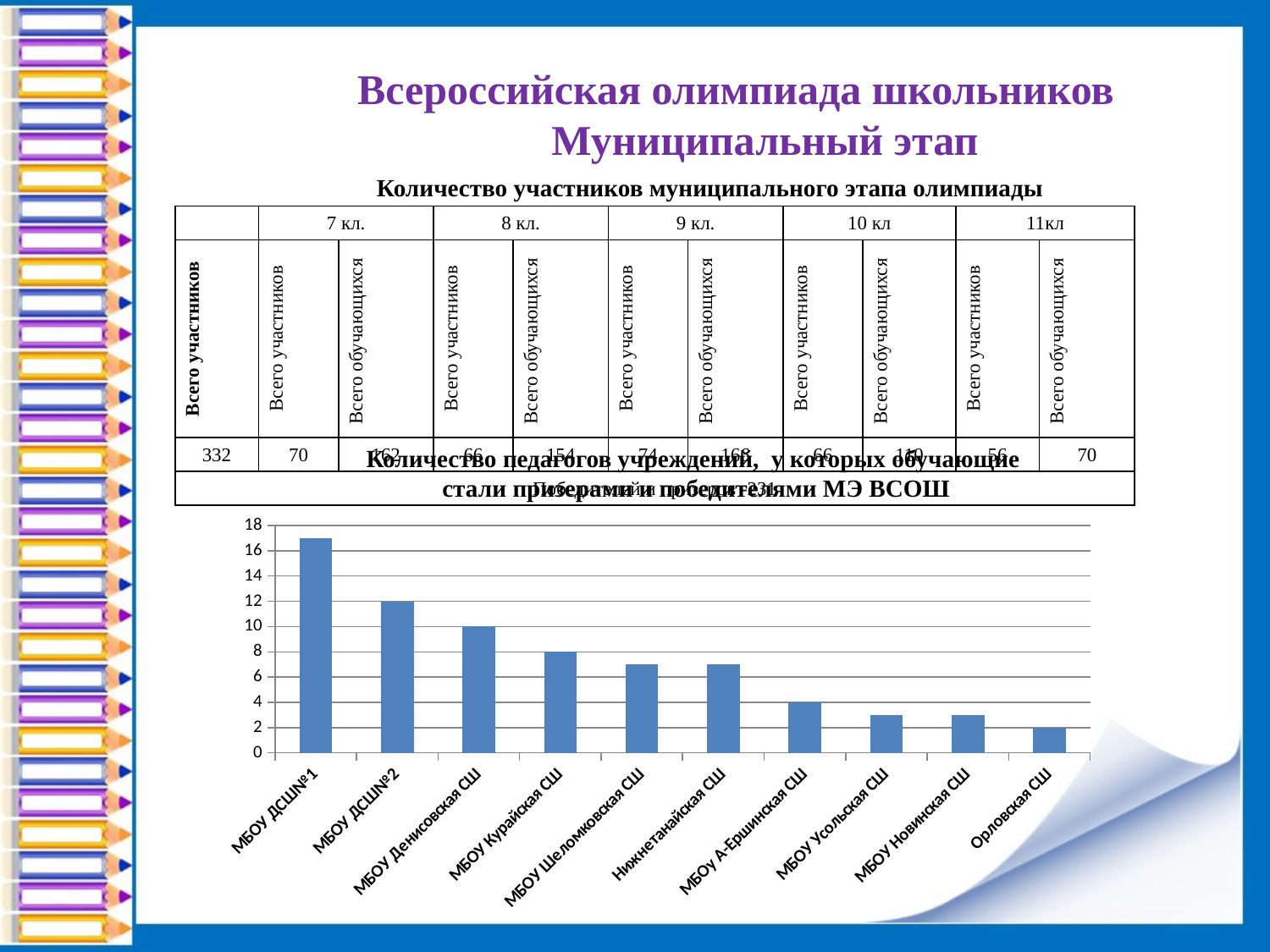
Which institution has the lowest bar on the chart? Орловская СШ Do the bar values rise or fall from left to right along the x axis? fall What is the value for Орловская СШ on the chart? 2 What is the difference between the values for МБОУ ДСШ№2 and МБОУ Денисовская СШ? 2 Is the value for МБОУ ДСШ№1 greater or less than 16? greater What kind of chart is shown on the slide? bar chart Which is larger, the value for МБОУ А-Ершинская СШ or the value for МБОУ Усольская СШ? МБОУ А-Ершинская СШ What is the value for МБОУ Курайская СШ on the chart? 8 What is the value for МБОУ ДСШ№2 on the chart? 12 Which institution has the highest bar on the chart? МБОУ ДСШ№1 How many institutions (categories) are shown on the bar chart? 10 What is the value for МБОУ Денисовская СШ on the chart? 10